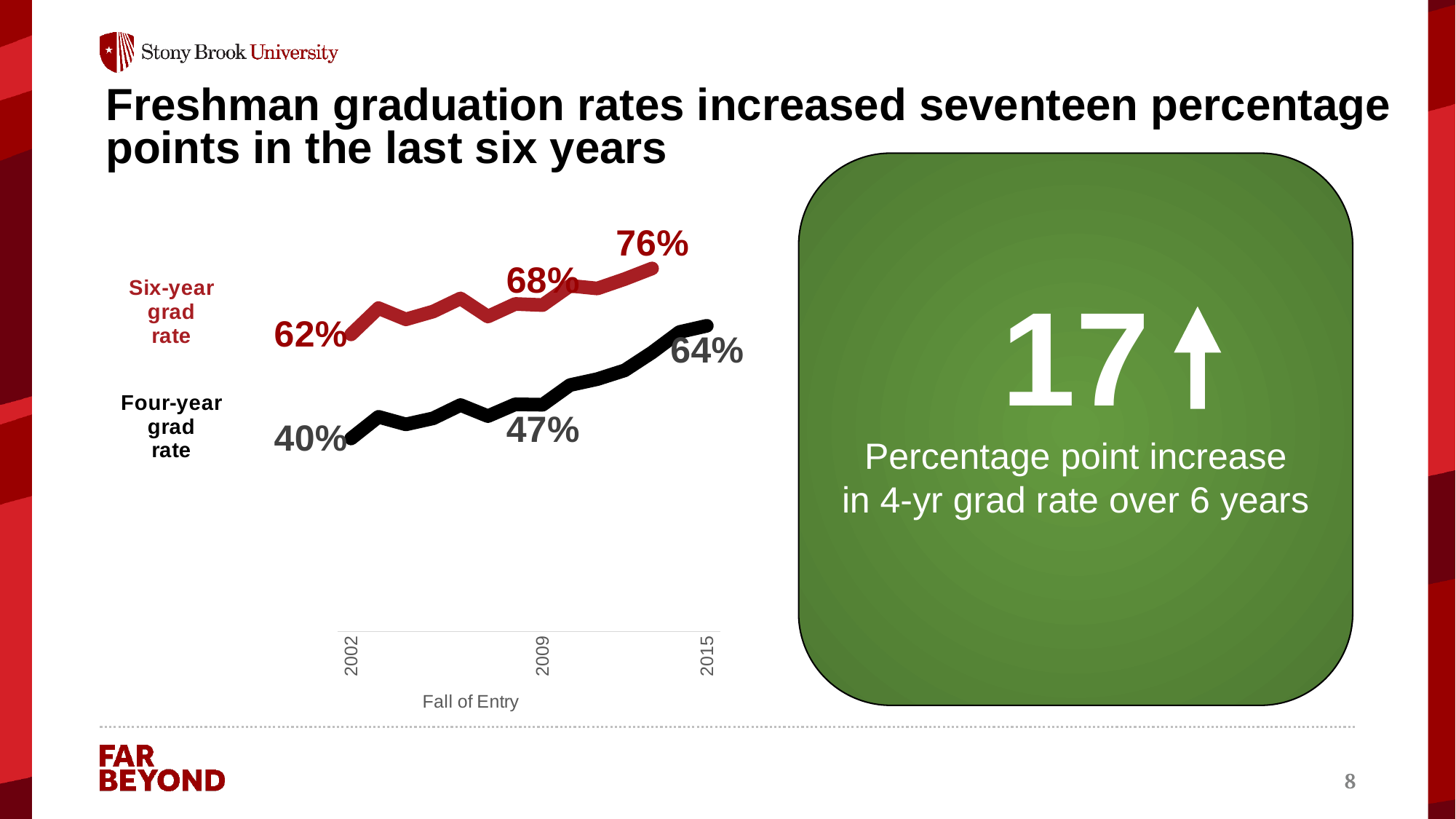
What was the four-year grad rate for the fall 2009 entry cohort? 47% What is the most recent six-year grad rate shown on the chart? 76% What kind of chart is shown on the slide? line chart Which series has the higher value for the fall 2009 cohort, six-year grad rate or four-year grad rate? Six-year grad rate What was the six-year grad rate for the fall 2002 entry cohort? 62% What was the six-year grad rate for the fall 2009 entry cohort? 68% What is the label on the x axis of the chart? Fall of Entry By how many percentage points did the four-year grad rate rise from 47% to its latest labelled value? 17 What is the most recent four-year grad rate shown on the chart? 64% What was the four-year grad rate for the fall 2002 entry cohort? 40% Do the four-year grad rate values rise or fall from 2002 to 2015? rise What is the difference between the six-year and four-year grad rates for the fall 2002 cohort? 22 percentage points